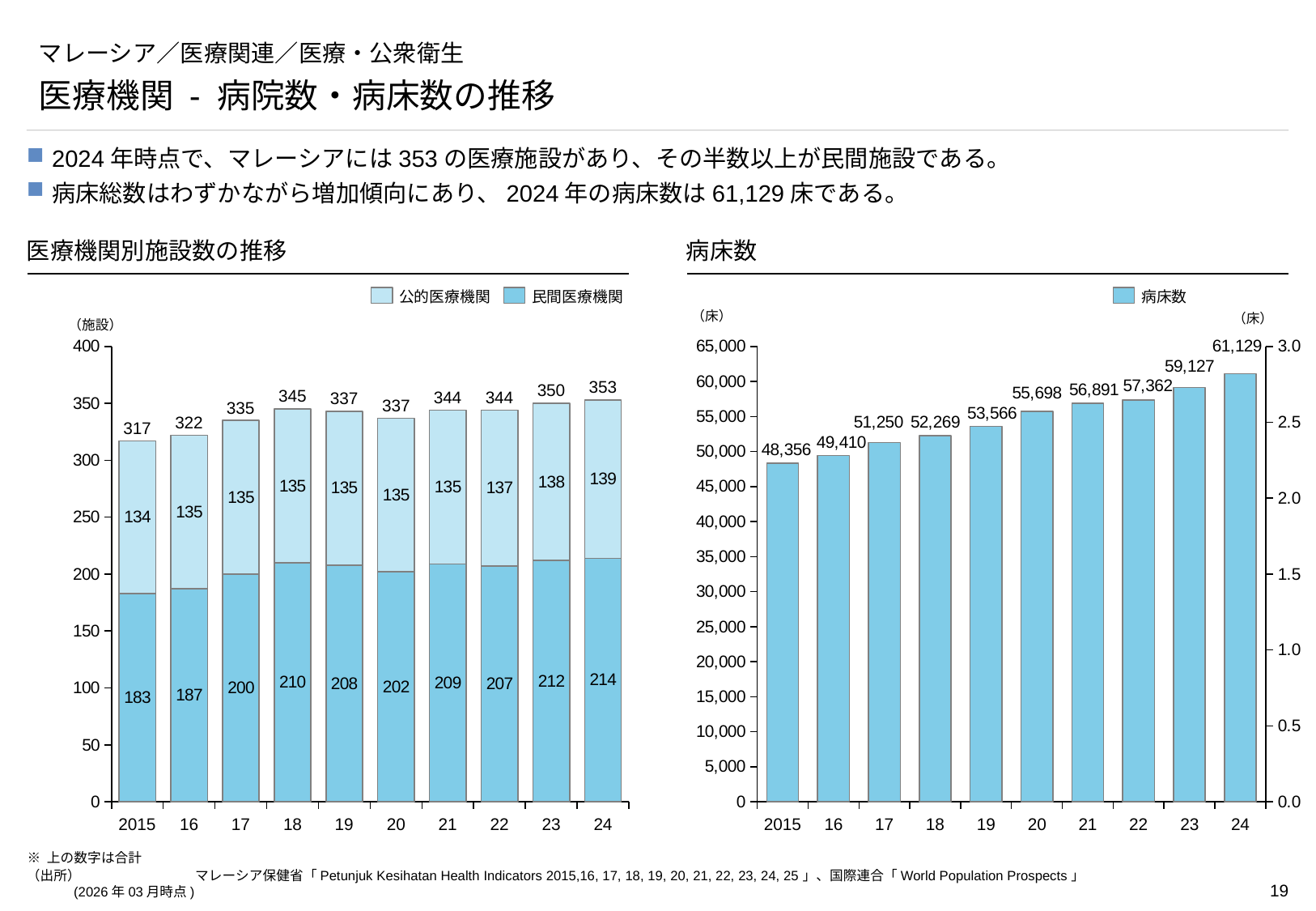
In the 病床数 chart, which year has the lowest value? 2015 In the 医療機関別施設数の推移 chart, what is the difference between the 民間医療機関 values for 2024 and 2015? 31 In the 医療機関別施設数の推移 chart, what is the total of the stacked bar for 2018? 345 In the 病床数 chart, do the values rise or fall from 2015 to 2024? rise In the 病床数 chart, what is the value for 2024? 61,129 In the 病床数 chart, what is the difference between the values for 2023 and 2022? 1,765 In the 医療機関別施設数の推移 chart, what is the value for 公的医療機関 in 2015? 134 In the 医療機関別施設数の推移 chart, what is the value for 民間医療機関 in 2024? 214 In the 医療機関別施設数の推移 chart, which year has the highest total number of facilities? 24 In the 病床数 chart, how many years are plotted? 10 In the 医療機関別施設数の推移 chart, which is larger in 2020: 公的医療機関 or 民間医療機関? 民間医療機関 In the 医療機関別施設数の推移 chart, how many series does the legend list? 2